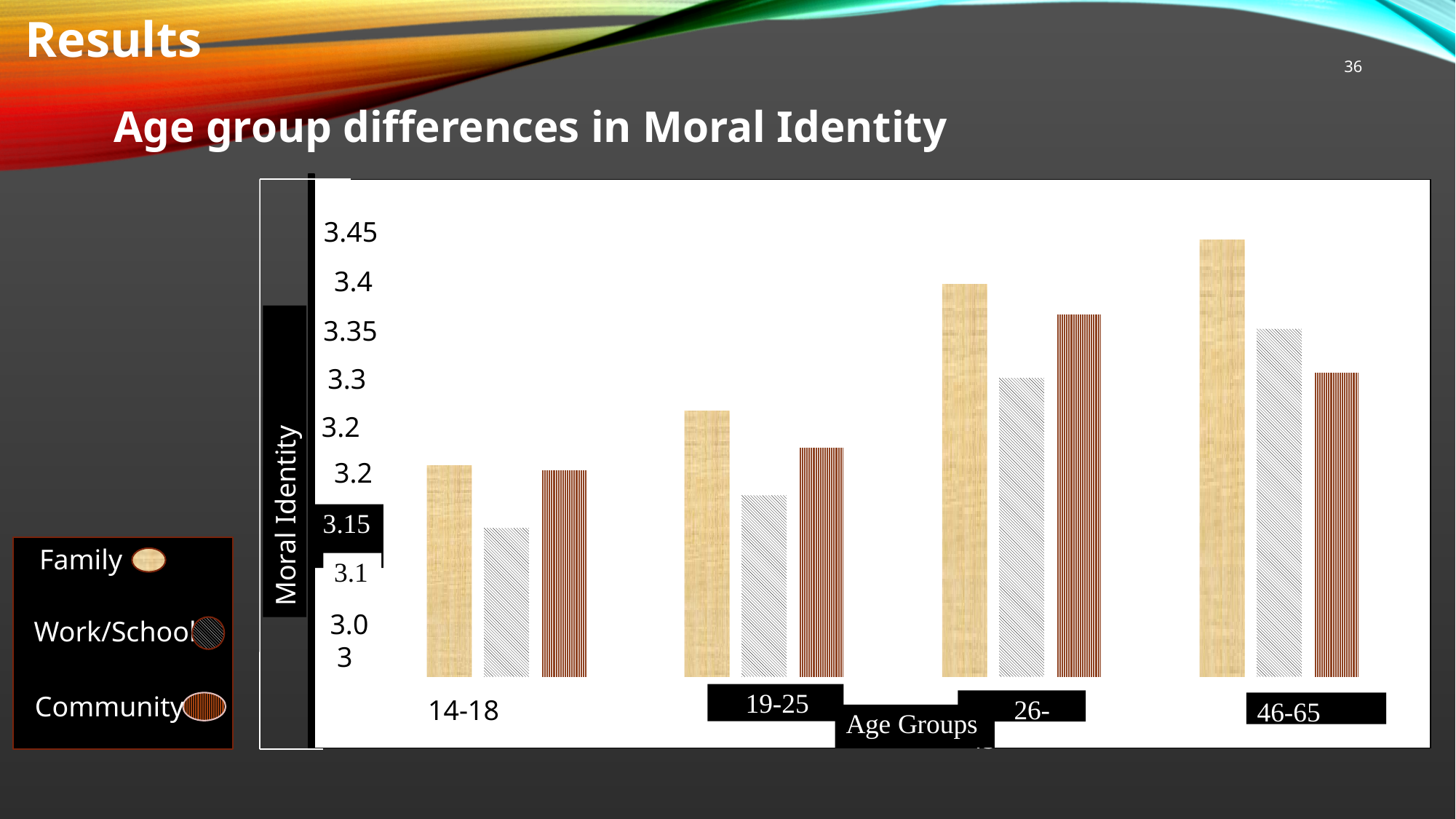
Which age group has the lowest Work/School bar? 14-18 Which age group has the lowest Community bar? 14-18 What is the title of the chart? Age group differences in Moral Identity How many age groups are shown on the x axis? 4 In the 46-65 age group, which is larger: Work/School or Community? Work/School How many series does the legend list? 3 Which series has the lowest value in the 19-25 age group? Work/School Do the Family values rise or fall as the age groups increase along the x axis? rise In the 14-18 age group, which is larger: Family or Work/School? Family What type of chart is shown on the slide? bar chart What is the title of the y axis? Moral Identity Which age group has the highest Family bar? 46-65